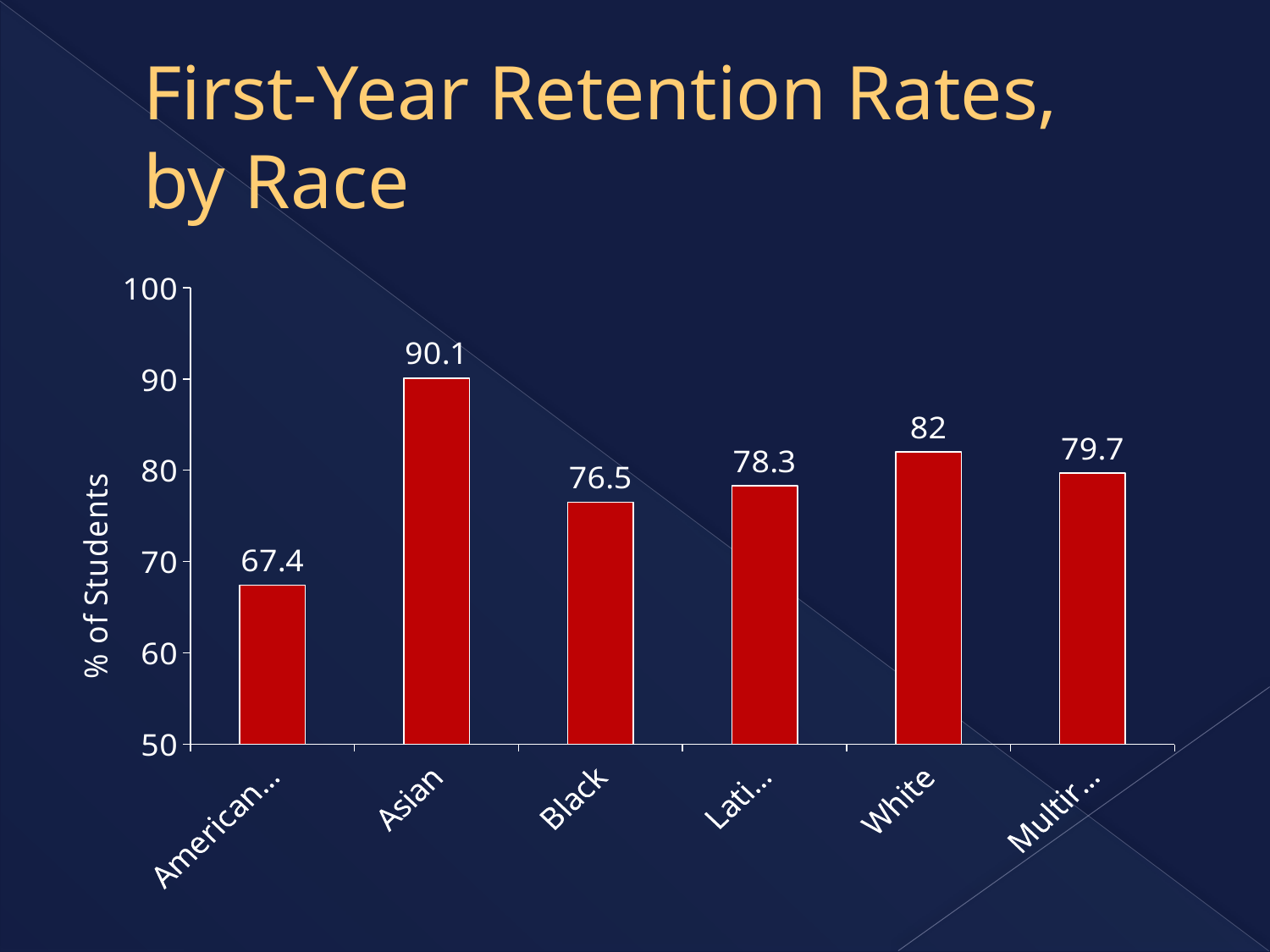
What is the first-year retention rate for Black students? 76.5 What is the first-year retention rate for Asian students? 90.1 What is the difference between the retention rates for Asian and Black students? 13.6 What is the difference between the retention rates for Asian and White students? 8.1 How many race categories are shown in the chart? 6 What is the difference between the retention rates for White and Black students? 5.5 Is the retention rate for Black students greater or less than 80? less What is the first-year retention rate for White students? 82 Which race category has the highest first-year retention rate? Asian What type of chart is shown on the slide? Bar chart What is the label on the vertical axis of the chart? % of Students Which has a higher retention rate, White or Black students? White